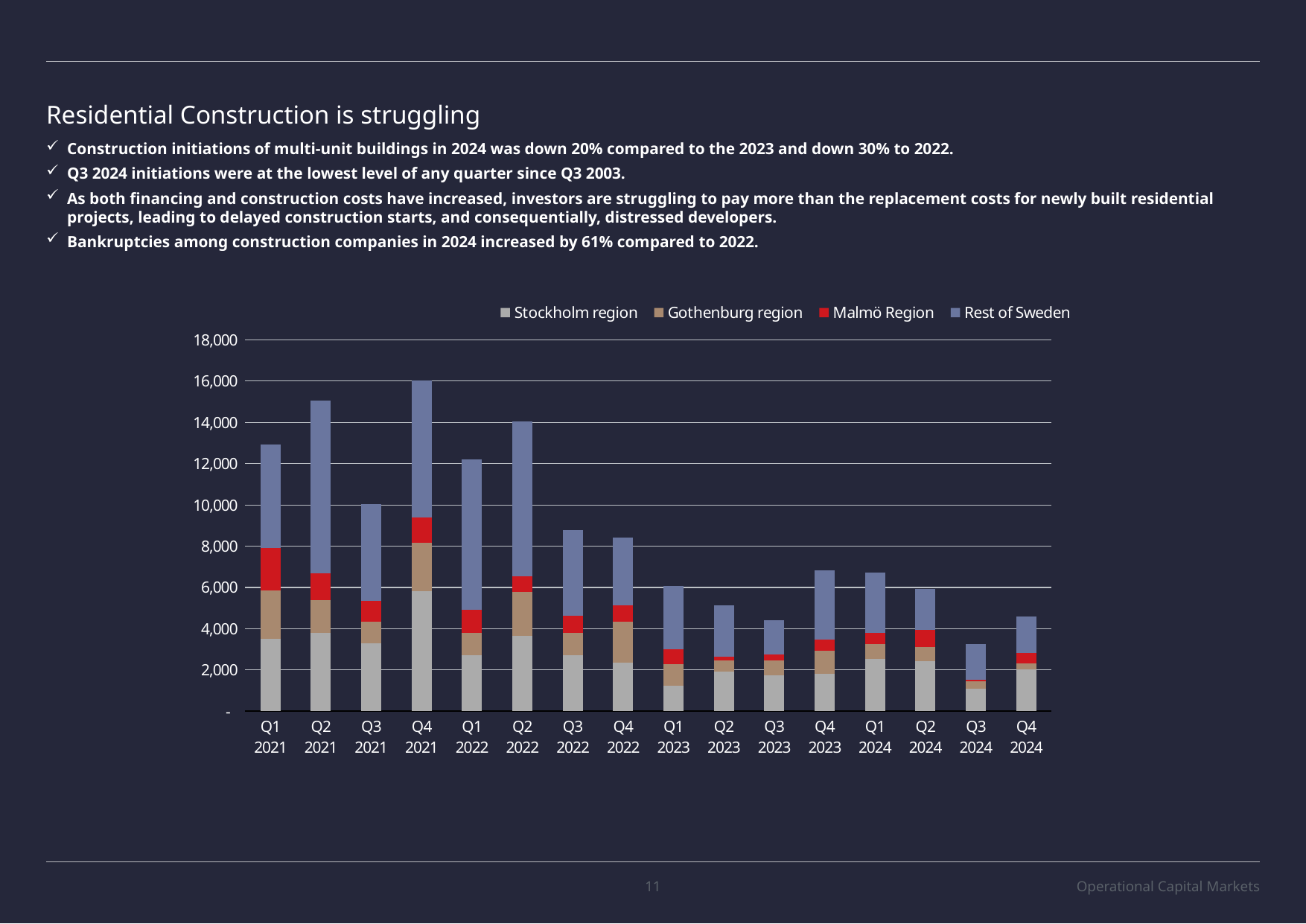
Which series is shown in red in the chart legend? Malmö Region Which has the larger total bar, Q3 2023 or Q4 2023? Q4 2023 How many series does the chart legend list? 4 How many quarters are shown along the x axis of the chart? 16 Do the total bar values generally rise or fall from Q1 2021 to Q4 2024? Fall What kind of chart is shown on the slide? Stacked bar chart Which has the larger total bar, Q2 2022 or Q3 2022? Q2 2022 Is the total value for Q1 2021 greater or less than 12,000? greater Which quarter has the lowest total stacked bar? Q3 2024 Is the total value for Q3 2024 greater or less than 4,000? less Which quarter has the highest total stacked bar? Q4 2021 Is the total value for Q1 2023 greater or less than 8,000? less